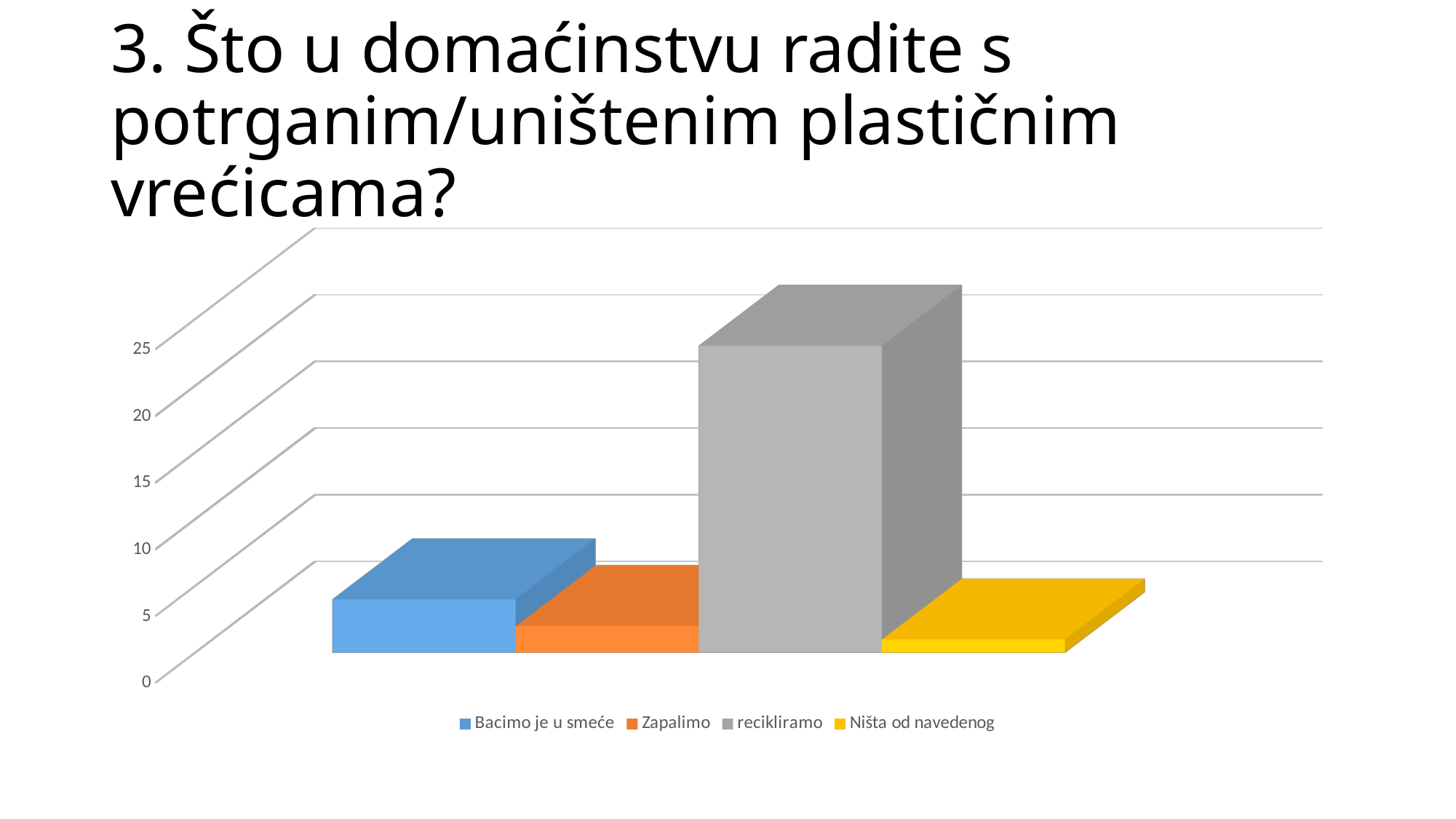
What colour is the bar for recikliramo? gray Which is larger, the value for Bacimo je u smeće or the value for Zapalimo? Bacimo je u smeće Which category has the lowest value? Ništa od navedenog Is the value for recikliramo greater or less than 20? greater How many bars are plotted in the chart? 4 Which is larger, the value for recikliramo or the value for Bacimo je u smeće? recikliramo Which category has the highest value? recikliramo Is the value for Bacimo je u smeće greater or less than 10? less What is the highest value shown on the vertical axis? 25 What kind of chart is shown on the slide? bar chart How many series does the legend list? 4 Is the value for Zapalimo greater or less than 5? less